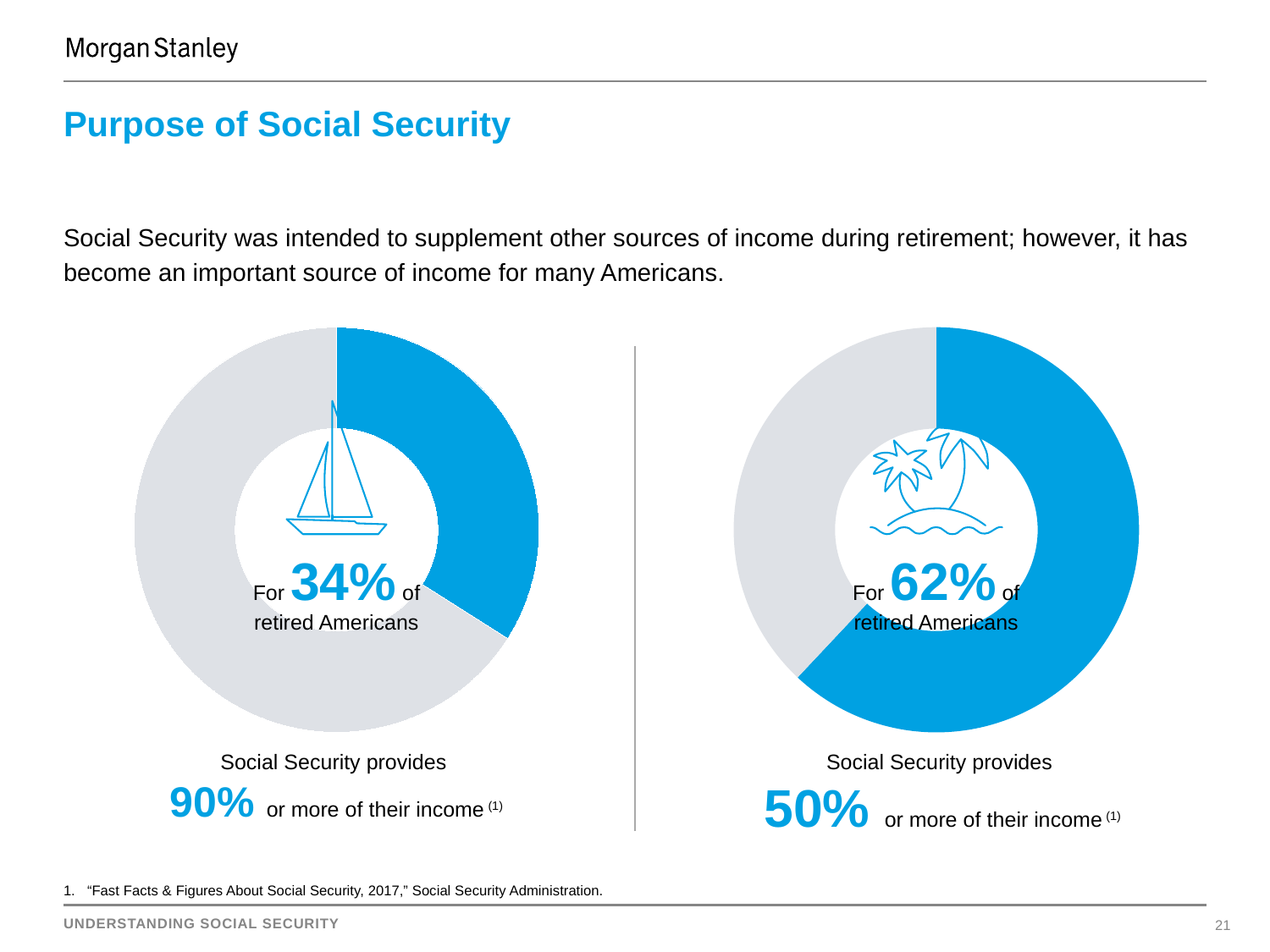
What kind of chart is shown on the left side of the slide? Donut chart Which donut chart shows the larger blue share, the left or the right? Right In the right donut chart, what percentage of retired Americans is highlighted in blue? 62% In the left donut chart, what share of the ring is grey (not highlighted)? 66% What is the difference between the percentage shown in the right donut chart and the percentage shown in the left donut chart? 28% In the right donut chart, what share of the ring is grey (not highlighted)? 38% Is the blue share in the right donut chart greater or less than 50%? greater According to the right chart, Social Security provides what share or more of income for 62% of retired Americans? 50% According to the left chart, Social Security provides what share or more of income for 34% of retired Americans? 90% What colour is used to highlight the share of retired Americans in both donut charts? Blue In the left donut chart, what percentage of retired Americans is highlighted in blue? 34% How many donut charts are shown on the slide? 2